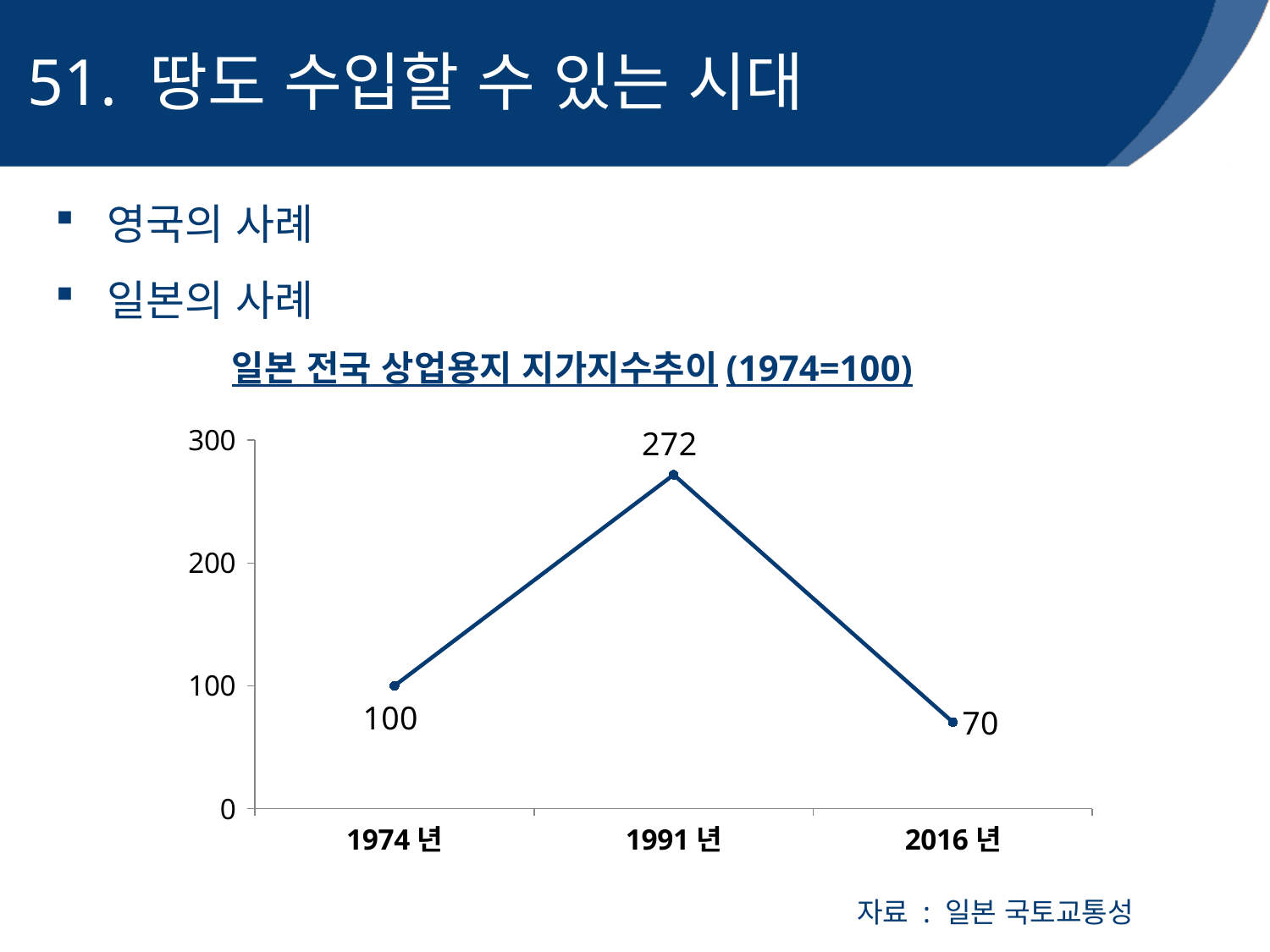
How many data points are plotted on the chart? 3 What is the value for 1991 년? 272 What is the difference between the values for 1991 년 and 1974 년? 172 What is the value for 2016 년? 70 Which year has the lowest value? 2016 년 Which is larger, the value for 1974 년 or the value for 2016 년? 1974 년 Is the value for 1991 년 greater or less than 200? greater What is the difference between the values for 1991 년 and 2016 년? 202 What kind of chart is shown on the slide? line chart Which year has the highest value? 1991 년 What is the value for 1974 년? 100 What is the title of the chart? 일본 전국 상업용지 지가지수추이 (1974=100)